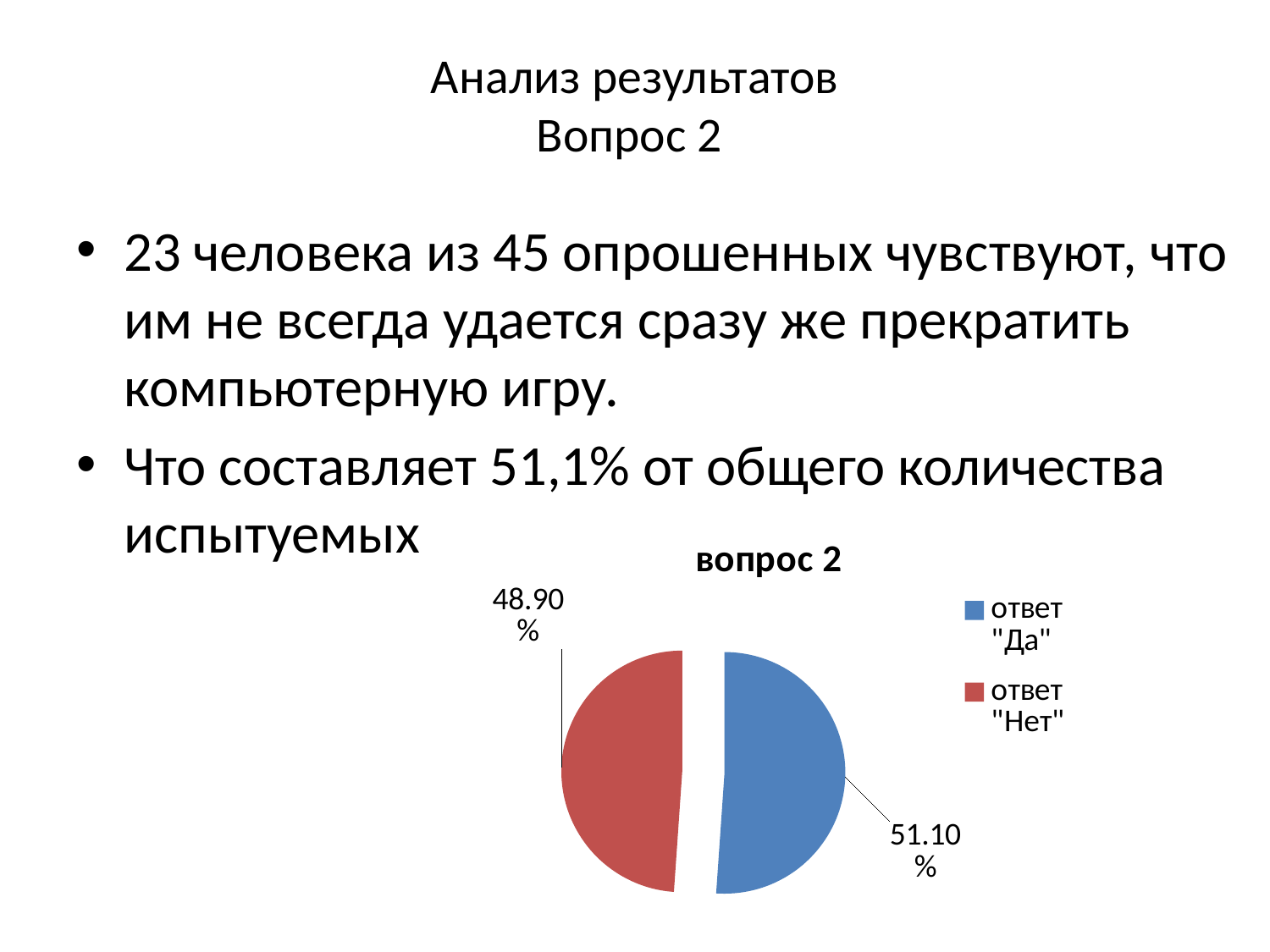
What share of the pie is labelled for ответ "Да"? 51.10% Which slice of the pie is the smallest? ответ "Нет" What kind of chart is shown on the slide? pie chart How many slices does the pie chart have? 2 How many entries does the legend list? 2 Which is larger, the share for ответ "Да" or the share for ответ "Нет"? ответ "Да" What is the title of the chart? вопрос 2 What is the difference between the shares for ответ "Да" and ответ "Нет"? 2.20% What share of the pie is labelled for ответ "Нет"? 48.90% What colour is the slice for ответ "Нет"? red Is the share for ответ "Да" greater or less than 50%? greater Which slice of the pie is the largest? ответ "Да"